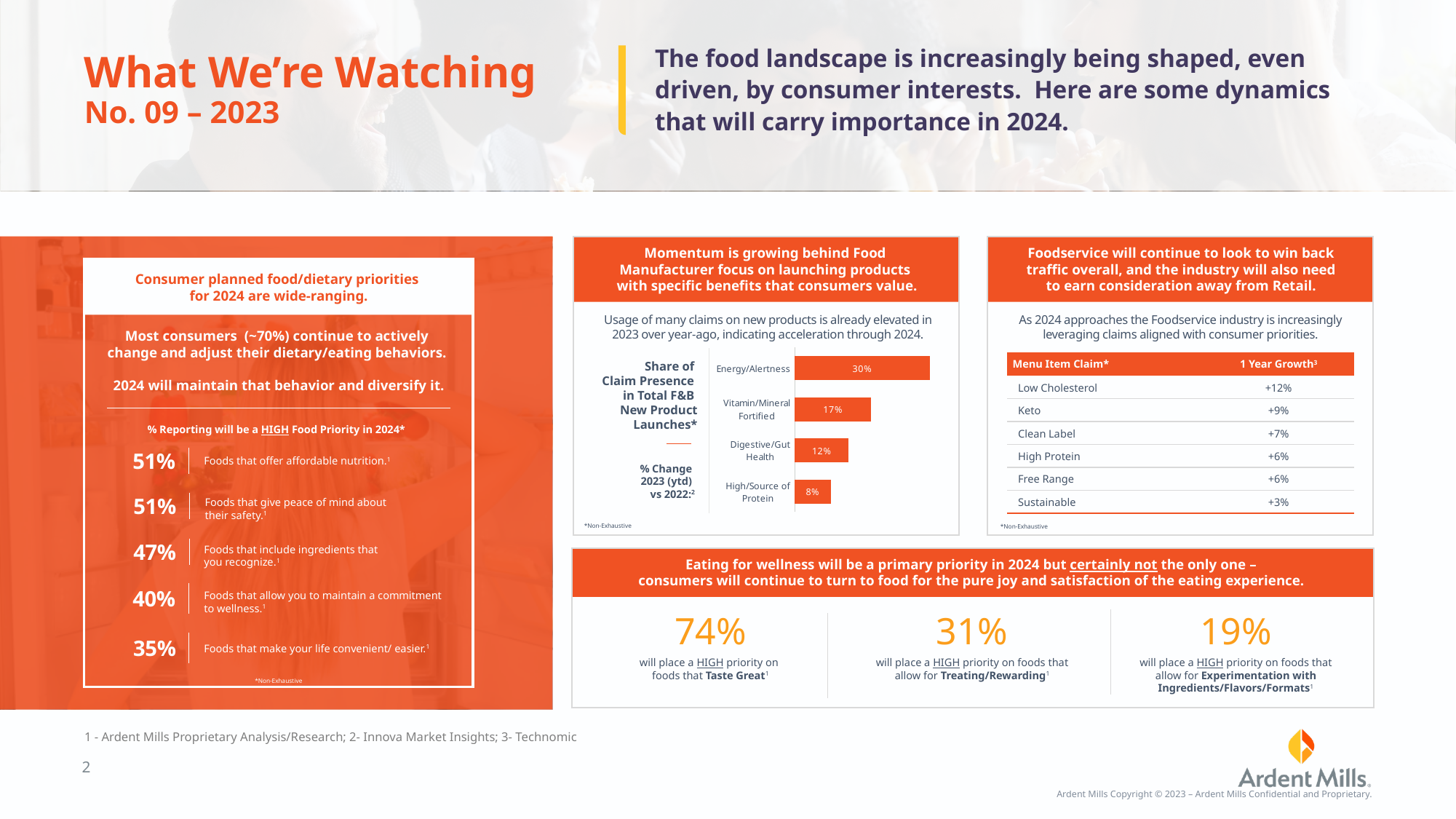
What kind of chart is shown in the middle panel of the slide? Bar chart In the bar chart in the middle panel, which claim has the highest value? Energy/Alertness In the bar chart in the middle panel, what is the value for High/Source of Protein? 8% How many claim categories are shown in the bar chart in the middle panel? 4 In the bar chart in the middle panel (Share of Claim Presence in Total F&B New Product Launches), what is the value for Energy/Alertness? 30% In the bar chart in the middle panel, what is the value for Digestive/Gut Health? 12% In the bar chart in the middle panel, which is larger: the value for Vitamin/Mineral Fortified or the value for Digestive/Gut Health? Vitamin/Mineral Fortified In the bar chart in the middle panel, what comparison period do the % change values represent? 2023 (ytd) vs 2022 In the bar chart in the middle panel, what is the difference between the values for Energy/Alertness and Vitamin/Mineral Fortified? 13% In the bar chart in the middle panel, which claim has the lowest value? High/Source of Protein In the bar chart in the middle panel, what is the value for Vitamin/Mineral Fortified? 17% In the bar chart in the middle panel, what is the difference between the values for Digestive/Gut Health and High/Source of Protein? 4%